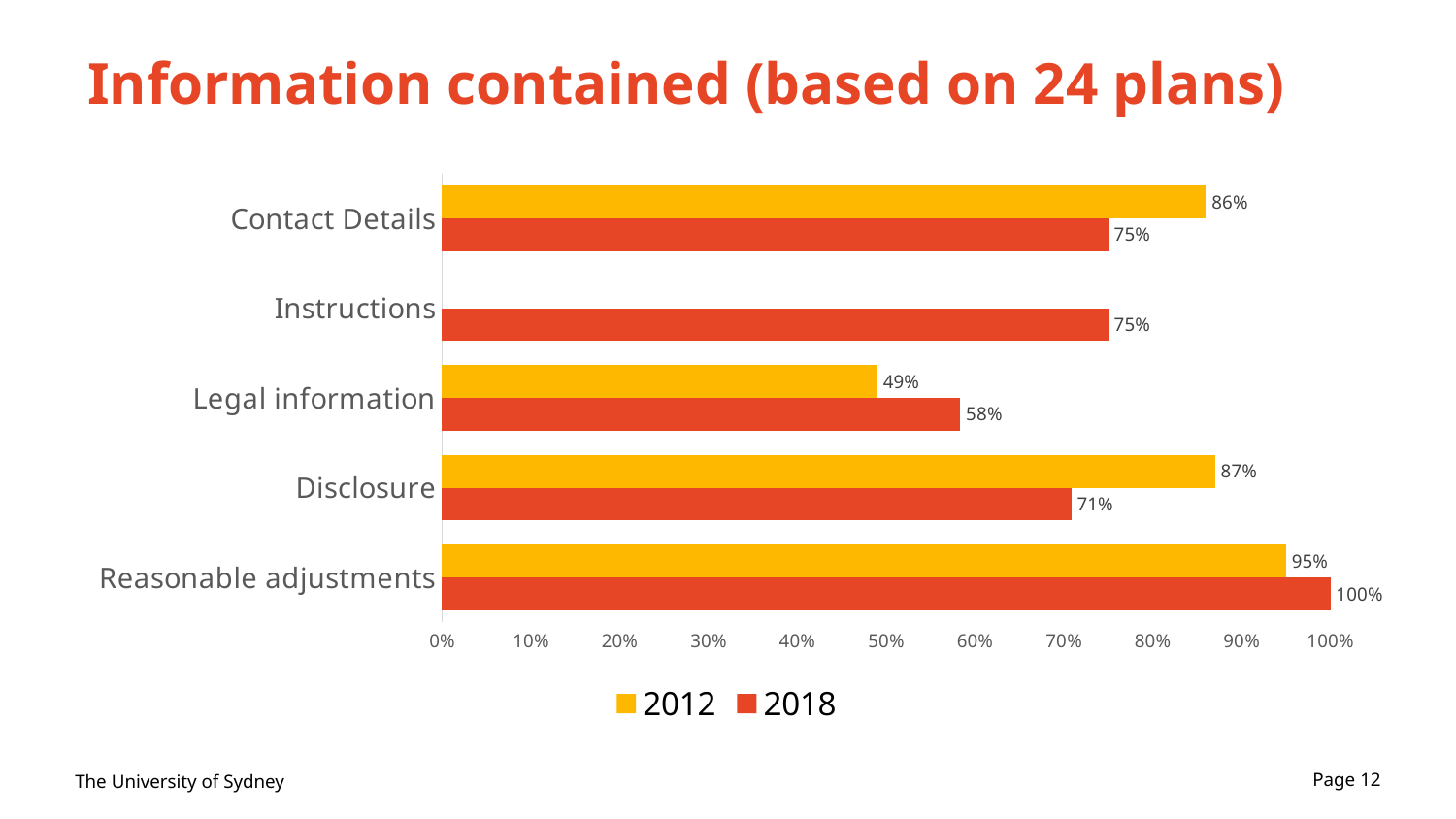
What is the 2018 value for Instructions? 75% What is the 2018 value for Legal information? 58% What kind of chart is shown on the slide? bar chart Is the 2018 value for Disclosure greater or less than 80%? less What is the 2012 value for Contact Details? 86% Which category has the lowest 2012 value? Legal information How many series does the legend list? 2 What is the title of the slide? Information contained (based on 24 plans) Which is larger for Legal information, the 2012 value or the 2018 value? 2018 What is the difference between the 2012 and 2018 values for Disclosure? 16% How many categories are shown on the y axis? 5 Which category has the highest 2018 value? Reasonable adjustments